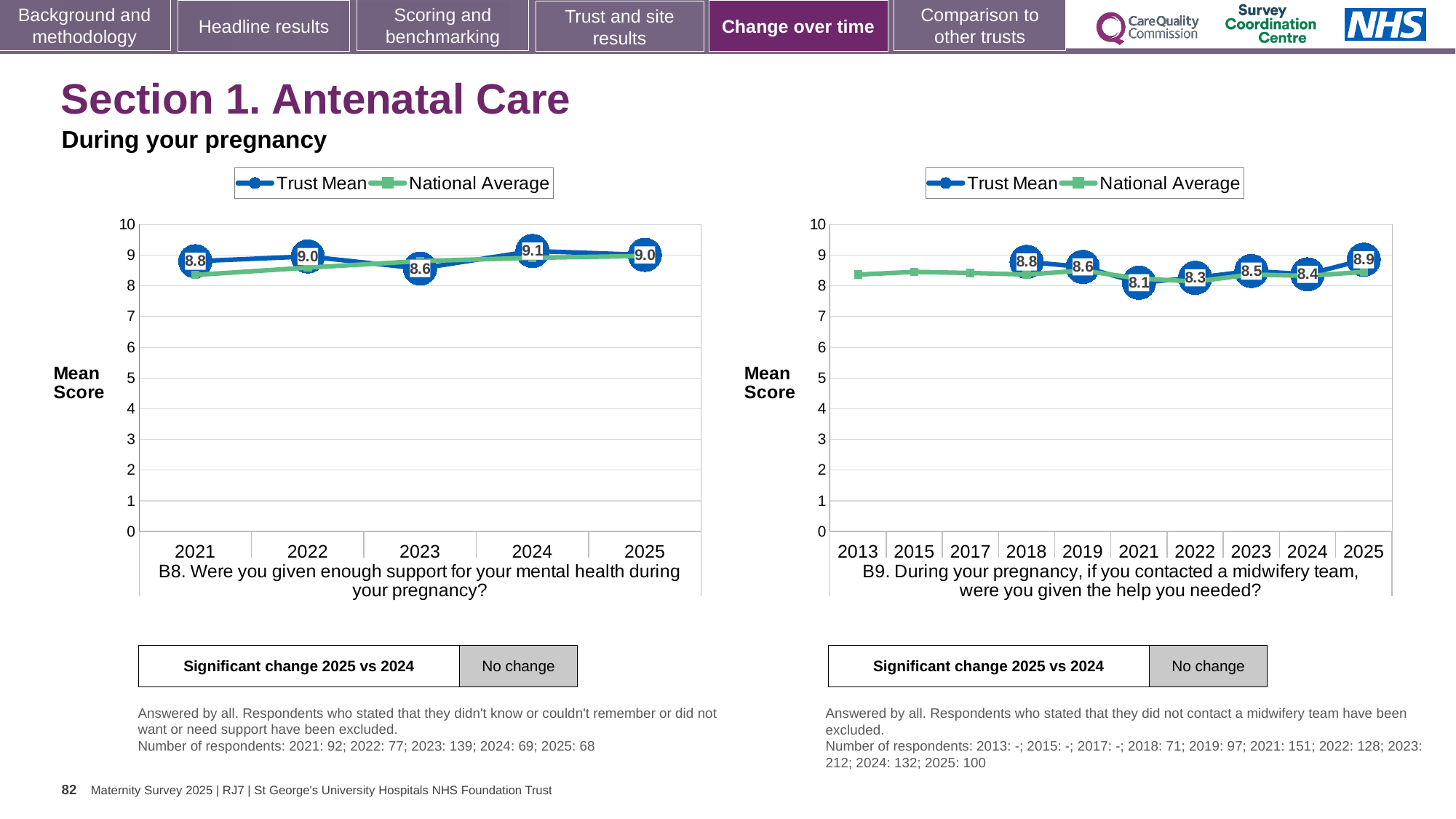
In the B9 chart on the right, what is the Trust Mean for 2025? 8.9 In the B8 chart on the left, which year has the lowest Trust Mean? 2023 How many series does the legend of the B8 chart on the left list? 2 In the B8 chart on the left, what is the Trust Mean for 2024? 9.1 In the B9 chart on the right, is the Trust Mean higher in 2018 or in 2019? 2018 In the B9 chart on the right, how many years are shown on the x axis? 10 In the B8 chart on the left, what is the difference between the Trust Mean for 2024 and 2023? 0.5 In the B9 chart on the right, is the National Average for 2013 greater or less than 9? less In the B8 chart on the left, what is the Trust Mean for 2023? 8.6 In the B8 chart on the left, how many years are shown on the x axis? 5 In the B9 chart on the right, what is the Trust Mean for 2021? 8.1 In the B9 chart on the right, which year has the lowest labelled Trust Mean? 2021